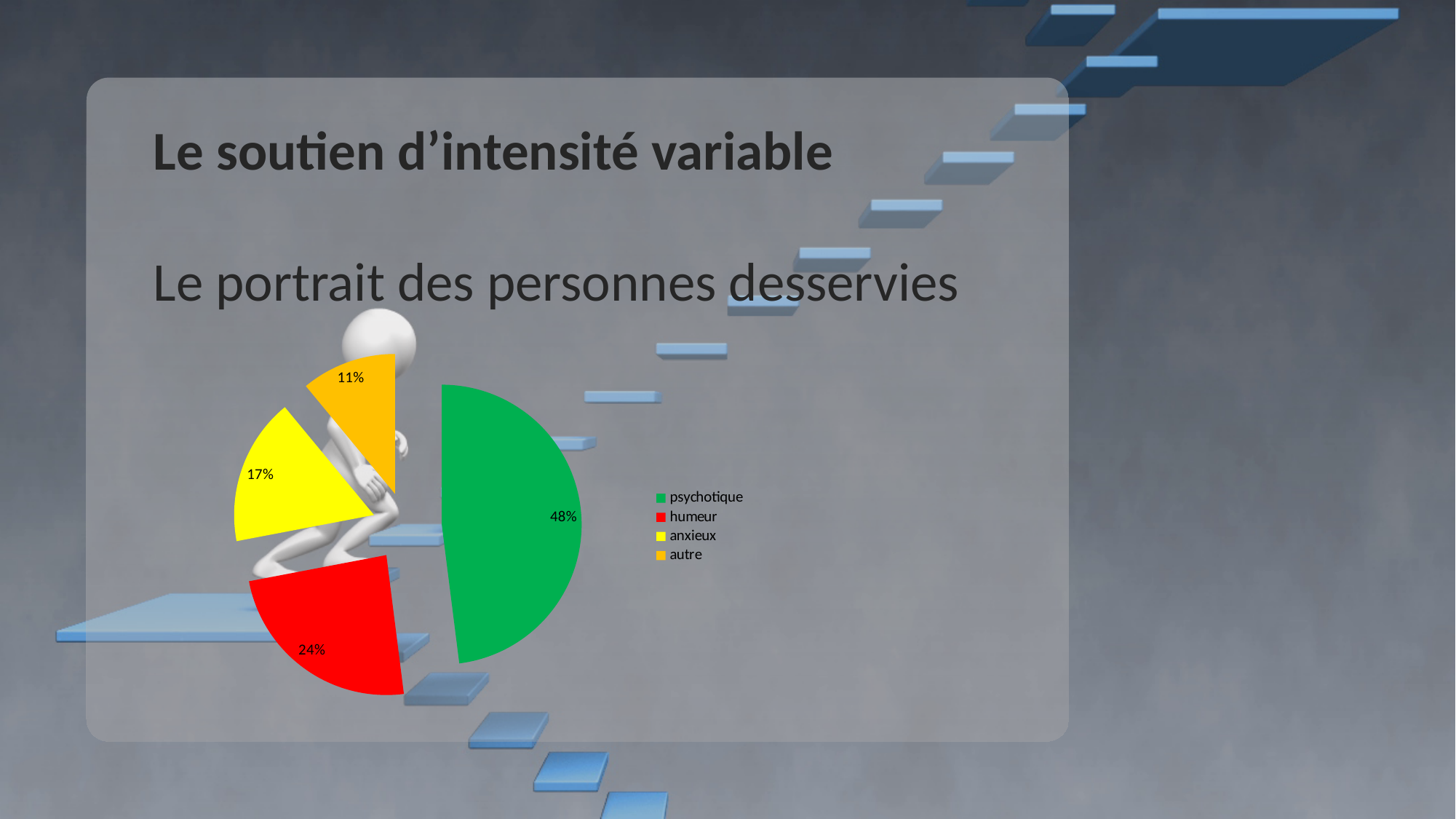
How many categories does the legend list? 4 What percentage is shown for the autre slice? 11% What percentage is shown for the humeur slice? 24% Which category has the smallest share of the pie? autre What colour is the humeur slice? red What colour is the psychotique slice? green Which category has the largest share of the pie? psychotique What kind of chart is shown on the slide? pie chart What is the difference in percentage points between the psychotique and humeur slices? 24 Which slice is larger, anxieux or autre? anxieux What percentage is shown for the anxieux slice? 17% What percentage of the pie is labelled for the psychotique slice? 48%